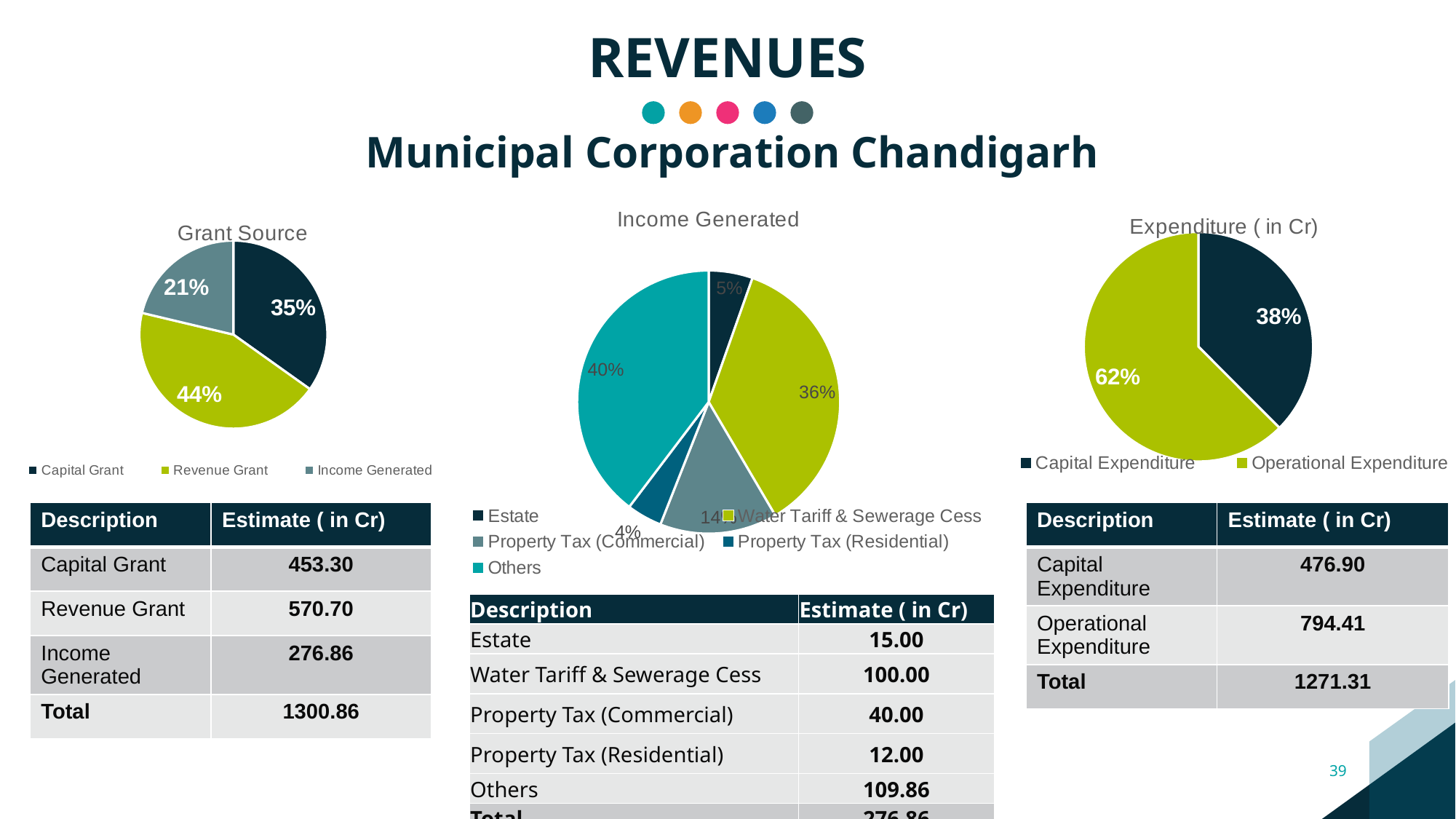
In the Income Generated chart, how many categories does the legend list? 5 In the Grant Source chart, what share does Capital Grant have? 35% In the Grant Source chart, which category has the smallest share? Income Generated In the Grant Source chart, which category has the largest share? Revenue Grant In the Grant Source chart, what share does Revenue Grant have? 44% In the Expenditure ( in Cr) chart, what share does Operational Expenditure have? 62% What kind of chart is the Expenditure ( in Cr) chart? pie chart In the Expenditure ( in Cr) chart, what is the difference in percentage points between Operational Expenditure and Capital Expenditure? 24 In the Income Generated chart, which category has the smallest share? Property Tax (Residential) In the Grant Source chart, how many categories does the legend list? 3